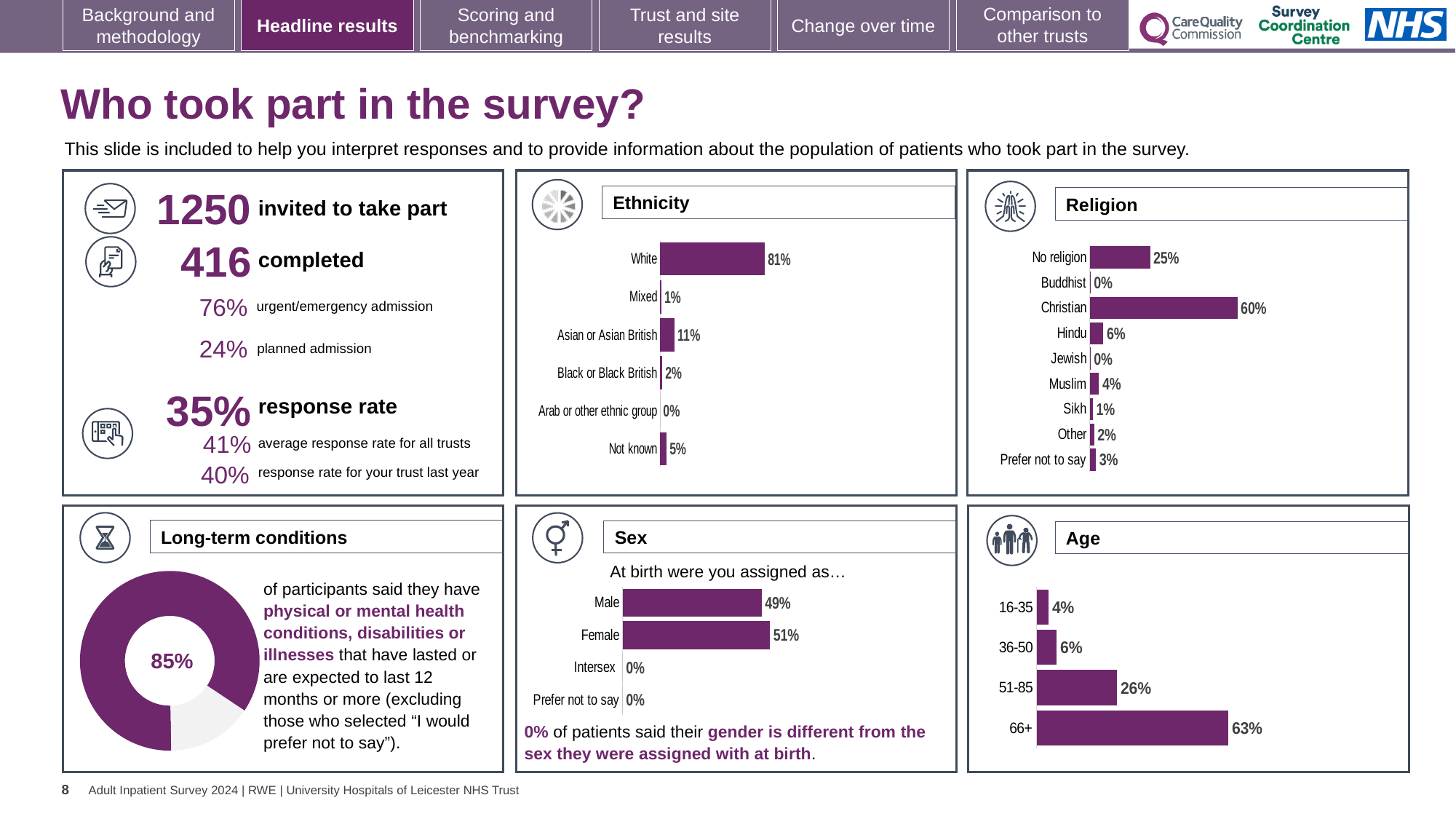
In the Religion chart, which is larger, No religion or Hindu? No religion In the Ethnicity chart, which category has the highest value? White In the Age chart, which age group has the highest value? 66+ In the Age chart, what percentage of respondents are aged 51-85? 26% In the Religion chart, how many religion categories are shown? 9 In the Ethnicity chart, what percentage of respondents are White? 81% In the Age chart, do the values rise or fall as age increases from 16-35 to 66+? rise What kind of chart is used in the Long-term conditions panel? Doughnut chart In the Sex chart, what percentage of respondents were assigned Female at birth? 51% In the Sex chart, what is the difference between the Female and Male values? 2% In the Ethnicity chart, what is the difference between the White and Asian or Asian British values? 70% In the Religion chart, what percentage of respondents are Christian? 60%